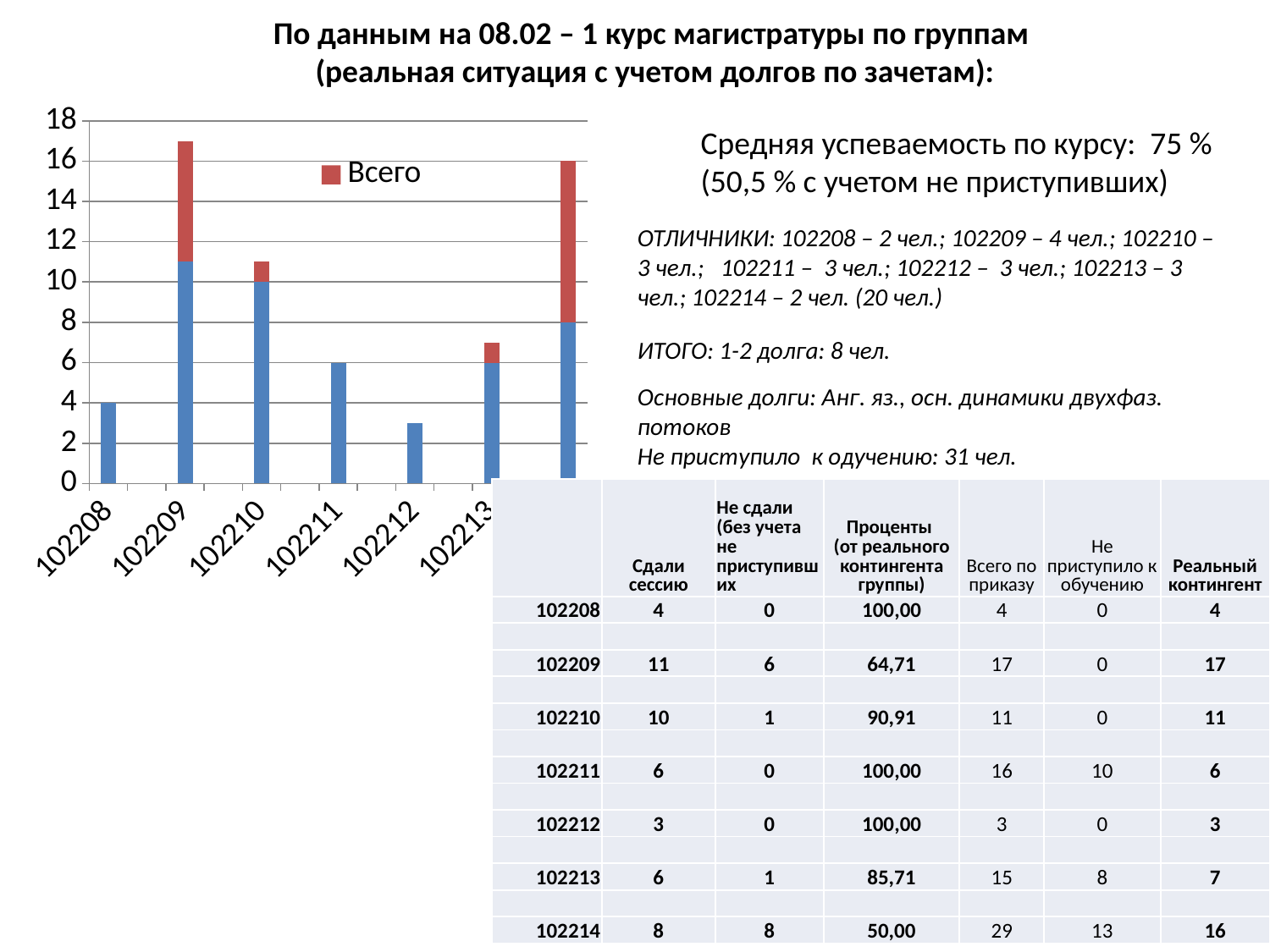
What is the only entry shown in the chart legend? Всего Which group has the tallest bar in the chart? 102209 Which group has the shortest bar in the chart? 102212 What colour represents the legend entry "Всего" in the chart? red What is the value of the bar for group 102208? 4 Which bar is taller, 102210 or 102211? 102210 What is the value of the bar for group 102211? 6 Is the total height of the bar for 102209 greater or less than 16? greater Is the value for 102212 greater or less than 4? less How many bars are plotted in the chart? 7 What is the height of the blue segment of the bar for group 102210? 10 What kind of chart is shown on the slide? bar chart